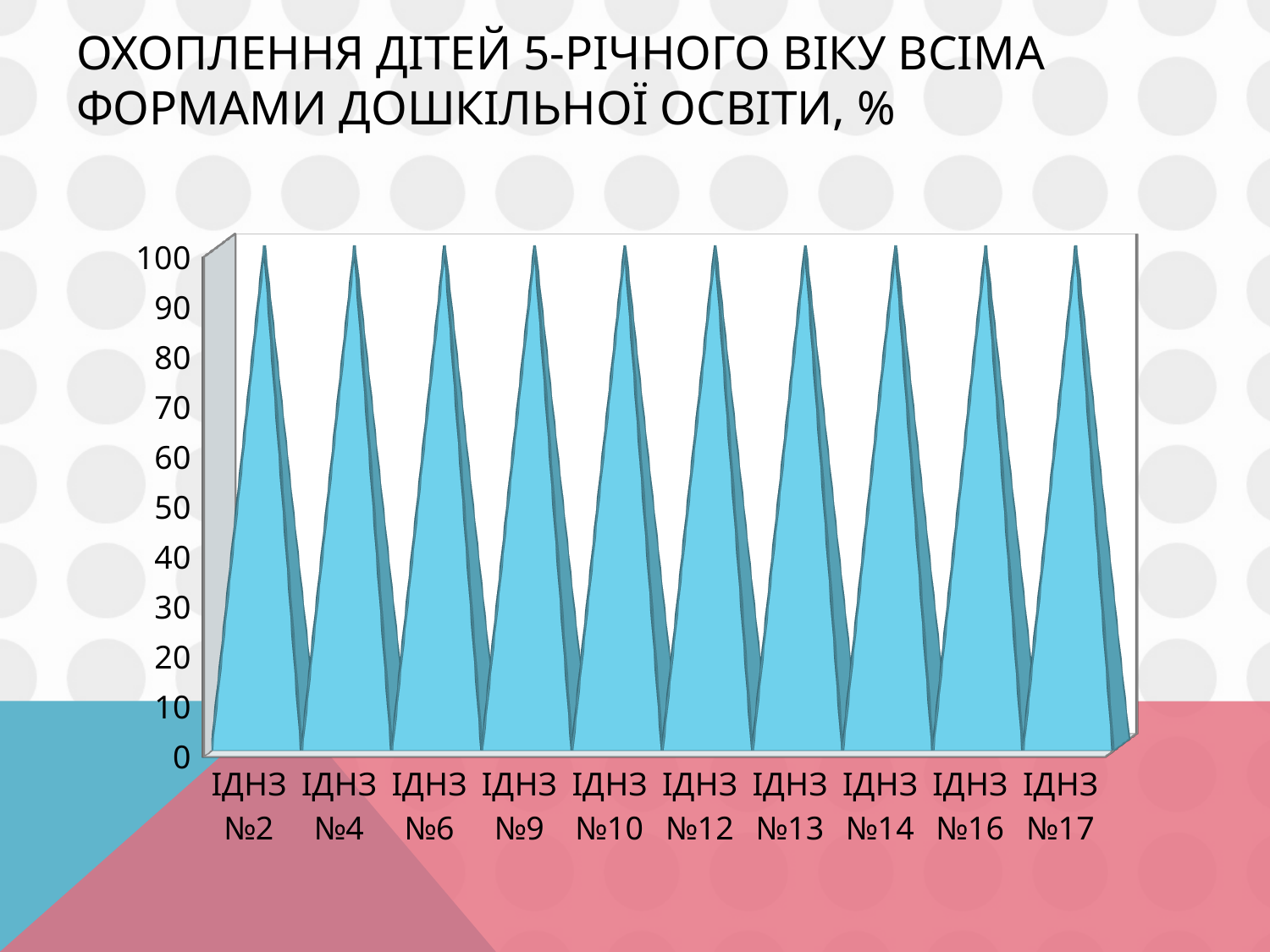
What is the highest value shown on the vertical axis? 100 Which category is the first one on the x axis? ІДНЗ №2 Is the value for ІДНЗ №14 greater or less than 90? greater What is the difference between the values for ІДНЗ №4 and ІДНЗ №12? 0 What kind of chart is shown on the slide? bar chart What is the title of the chart on the slide? ОХОПЛЕННЯ ДІТЕЙ 5-РІЧНОГО ВІКУ ВСІМА ФОРМАМИ ДОШКІЛЬНОЇ ОСВІТИ, % Do the values rise, fall, or stay the same across the categories from ІДНЗ №2 to ІДНЗ №17? stay the same What is the value for ІДНЗ №10? 100 What is the value for ІДНЗ №2? 100 Is the value for ІДНЗ №6 greater or less than 50? greater What is the value for ІДНЗ №17? 100 How many categories (ІДНЗ) are shown on the x axis of the chart? 10